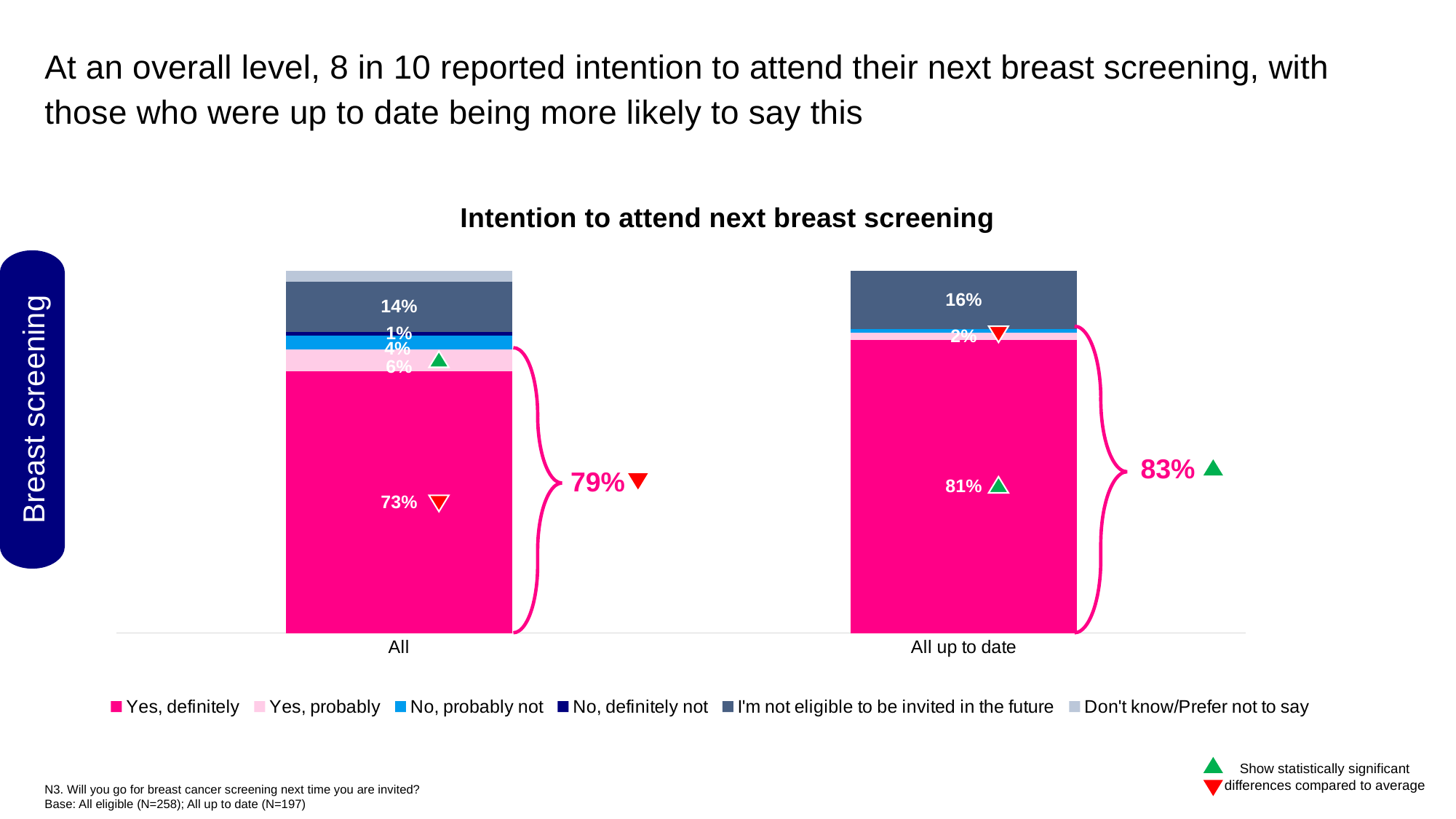
What is the 'I'm not eligible to be invited in the future' value for the 'All up to date' bar? 16% What percentage of the 'All' group said 'Yes, definitely'? 73% What is the 'Yes, probably' value for the 'All' bar? 6% What is the title of the chart? Intention to attend next breast screening What percentage of the 'All up to date' group said 'Yes, definitely'? 81% Which group has the higher 'Yes, definitely' value, 'All' or 'All up to date'? All up to date What is the difference between the 'Yes, definitely' values for 'All up to date' and 'All'? 8 percentage points How many series does the chart legend list? 6 How many bars (categories) are plotted in the chart? 2 What combined percentage is shown by the brace next to the 'All up to date' bar? 83% What type of chart is shown on the slide? Stacked bar chart What is the 'I'm not eligible to be invited in the future' value for the 'All' bar? 14%